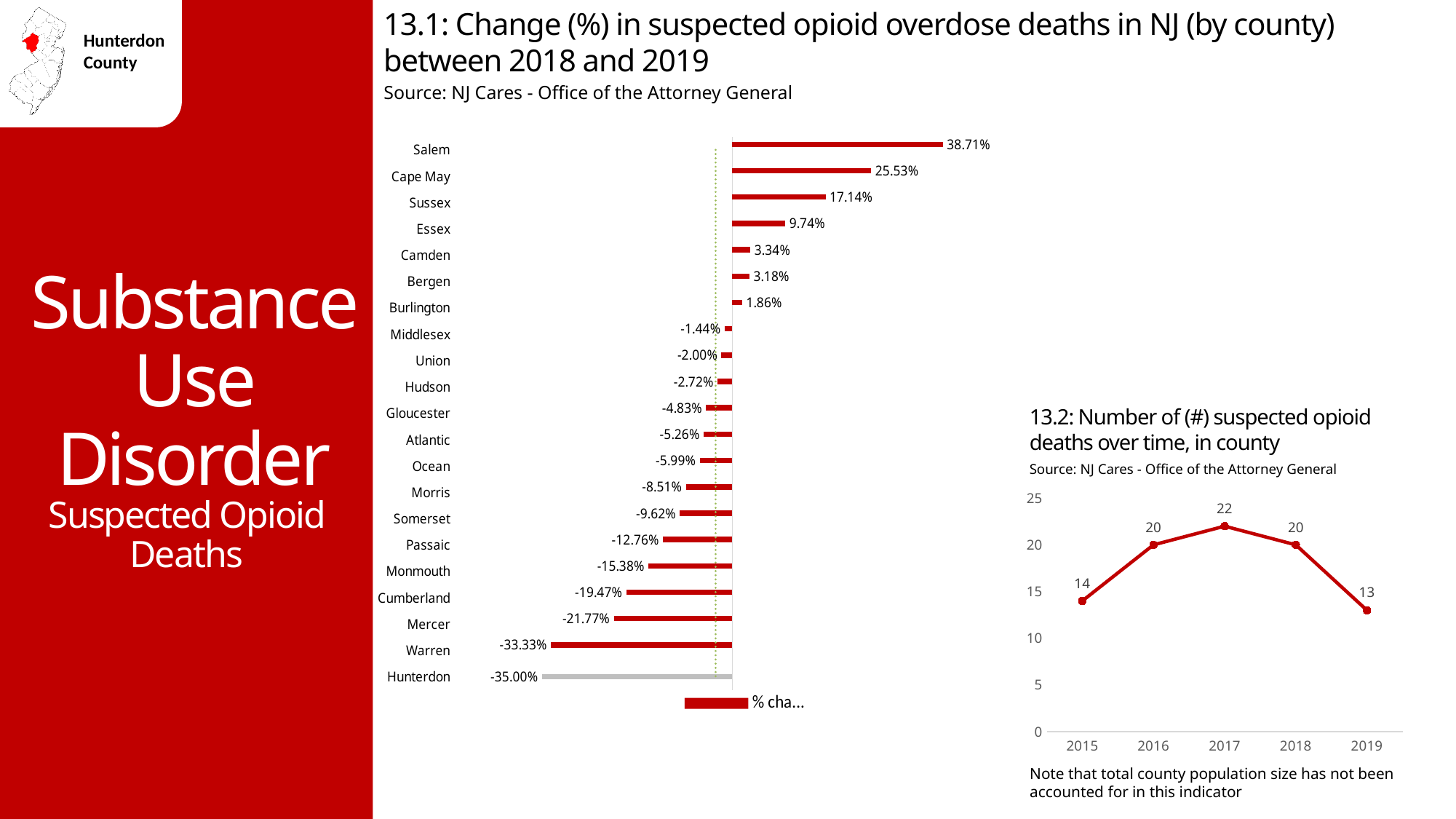
How many counties are shown in chart 13.1? 21 In chart 13.1, which county has the lowest change (%) in suspected opioid overdose deaths? Hunterdon In chart 13.1, what is the change (%) in suspected opioid overdose deaths for Hunterdon? -35.00% What kind of chart is chart 13.2? Line chart What kind of chart is chart 13.1? Bar chart In chart 13.1, which county has the highest change (%) in suspected opioid overdose deaths? Salem In chart 13.2, how many suspected opioid deaths were there in 2017? 22 In chart 13.1, what is the difference between the values for Salem and Cape May? 13.18% In chart 13.2, what is the difference in suspected opioid deaths between 2018 and 2019? 7 In chart 13.1, what is the change (%) in suspected opioid overdose deaths for Salem? 38.71% In chart 13.1, which county has a larger change (%): Sussex or Essex? Sussex In chart 13.2, which year has the lowest number of suspected opioid deaths? 2019